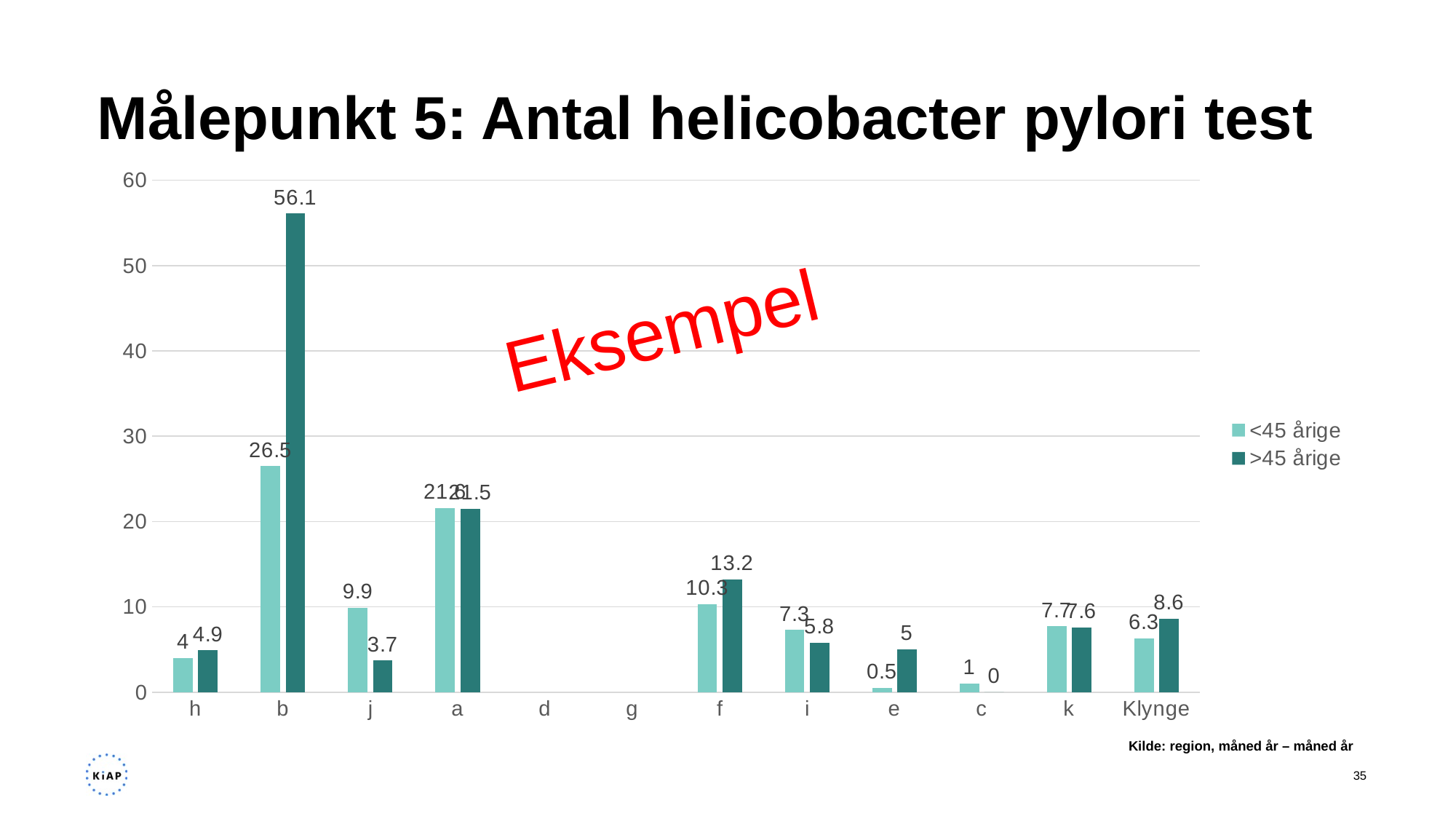
Is the value for b in the >45 årige series greater or less than 50? greater What is the value for b in the >45 årige series? 56.1 How many series does the legend list? 2 How many categories are shown on the x axis? 12 What is the difference between the >45 årige and <45 årige values for b? 29.6 What is the difference between the >45 årige and <45 årige values for e? 4.5 Which category has the lowest non-zero value in the <45 årige series? e What kind of chart is shown on the slide? Bar chart What is the value for Klynge in the <45 årige series? 6.3 What is the value for f in the >45 årige series? 13.2 Which is larger for j: the <45 årige value or the >45 årige value? <45 årige Which category has the highest value in the >45 årige series? b